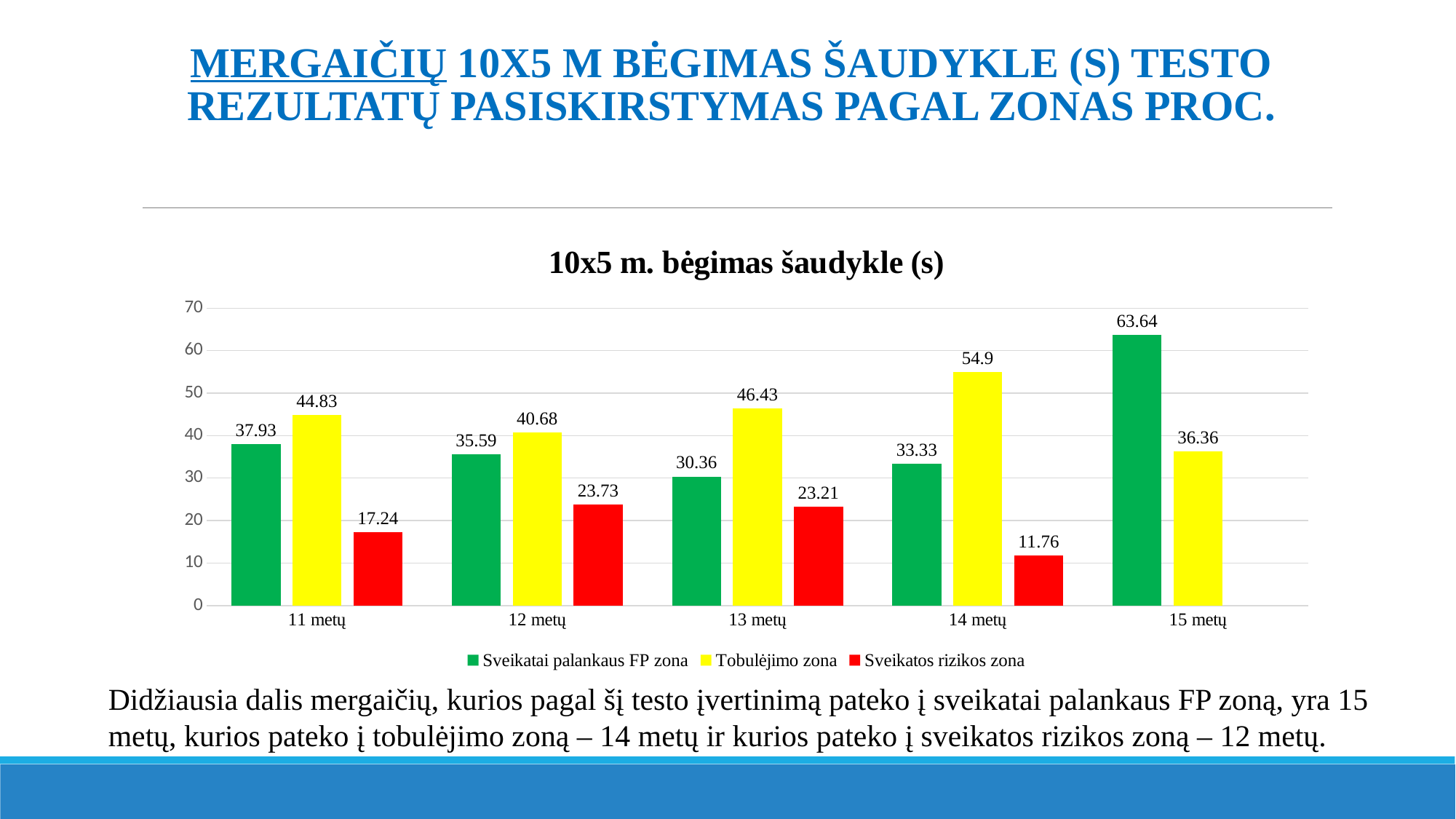
What is the value for Sveikatos rizikos zona at 12 metų? 23.73 Is the value for Sveikatos rizikos zona at 14 metų greater or less than 20? less How many age groups are shown on the x axis? 5 Which age group has the highest value for Sveikatos rizikos zona? 12 metų What is the value for Tobulėjimo zona at 14 metų? 54.9 Which age group has the lowest value for Sveikatai palankaus FP zona? 13 metų At 15 metų, which is larger: Sveikatai palankaus FP zona or Tobulėjimo zona? Sveikatai palankaus FP zona What colour represents Tobulėjimo zona in the chart? yellow What is the value for Sveikatai palankaus FP zona at 15 metų? 63.64 What is the difference between the Tobulėjimo zona and Sveikatai palankaus FP zona values at 11 metų? 6.9 How many series does the legend list? 3 What kind of chart is shown on the slide? bar chart